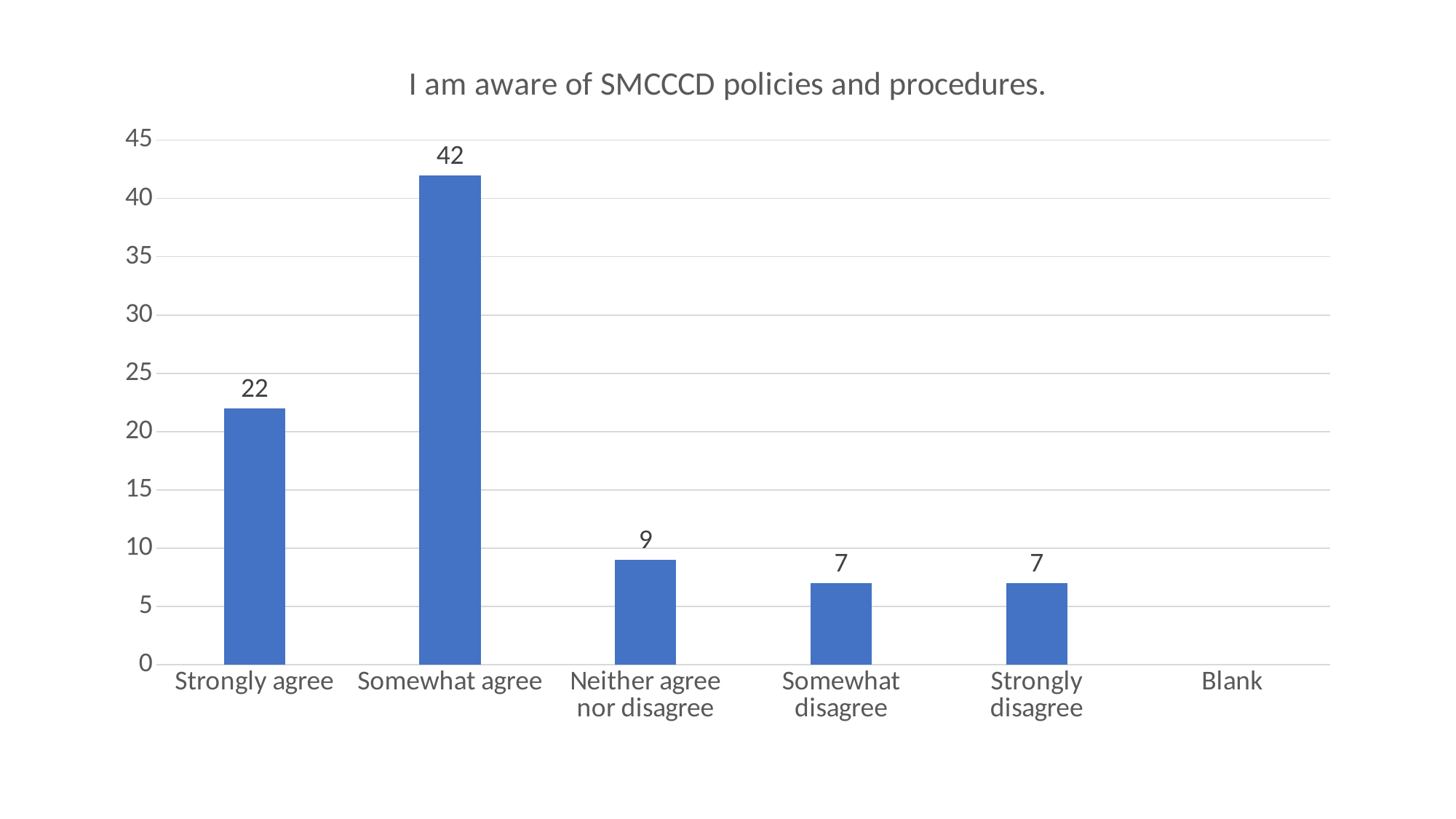
What is the value for Strongly disagree? 7 Is the value for Somewhat agree greater or less than 40? greater Which is larger, the value for Strongly agree or the value for Neither agree nor disagree? Strongly agree What is the value for Somewhat agree? 42 What is the value for Strongly agree? 22 What is the difference between the values for Neither agree nor disagree and Somewhat disagree? 2 What kind of chart is this? bar chart What is the difference between the values for Somewhat agree and Strongly agree? 20 How many categories are shown on the x axis? 6 Which category has the highest value? Somewhat agree What is the value for Neither agree nor disagree? 9 What is the title of the chart? I am aware of SMCCCD policies and procedures.